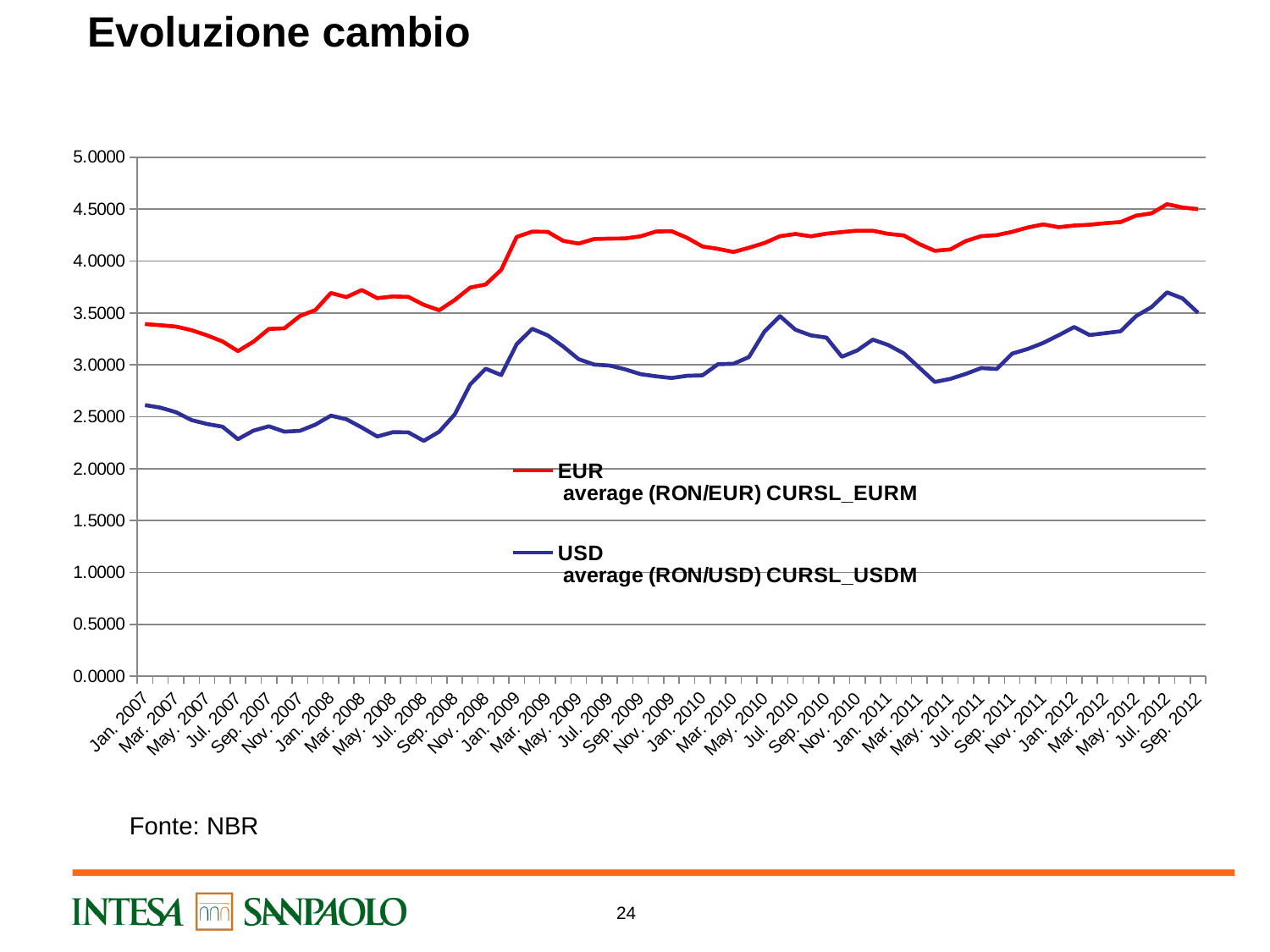
Is the EUR value in Mar. 2009 greater or less than 4.0000? greater How many series does the legend list? 2 Is the USD value in Jul. 2012 greater or less than 3.5000? greater What kind of chart is shown on the slide? line chart Is the USD value in Jul. 2008 greater or less than 2.5000? less Which series has the higher value in Jan. 2007, EUR or USD? EUR Does the EUR series overall rise or fall from Jan. 2007 to Sep. 2012? rise Which two series are shown in the legend? EUR and USD What is the title of the chart on the slide? Evoluzione cambio